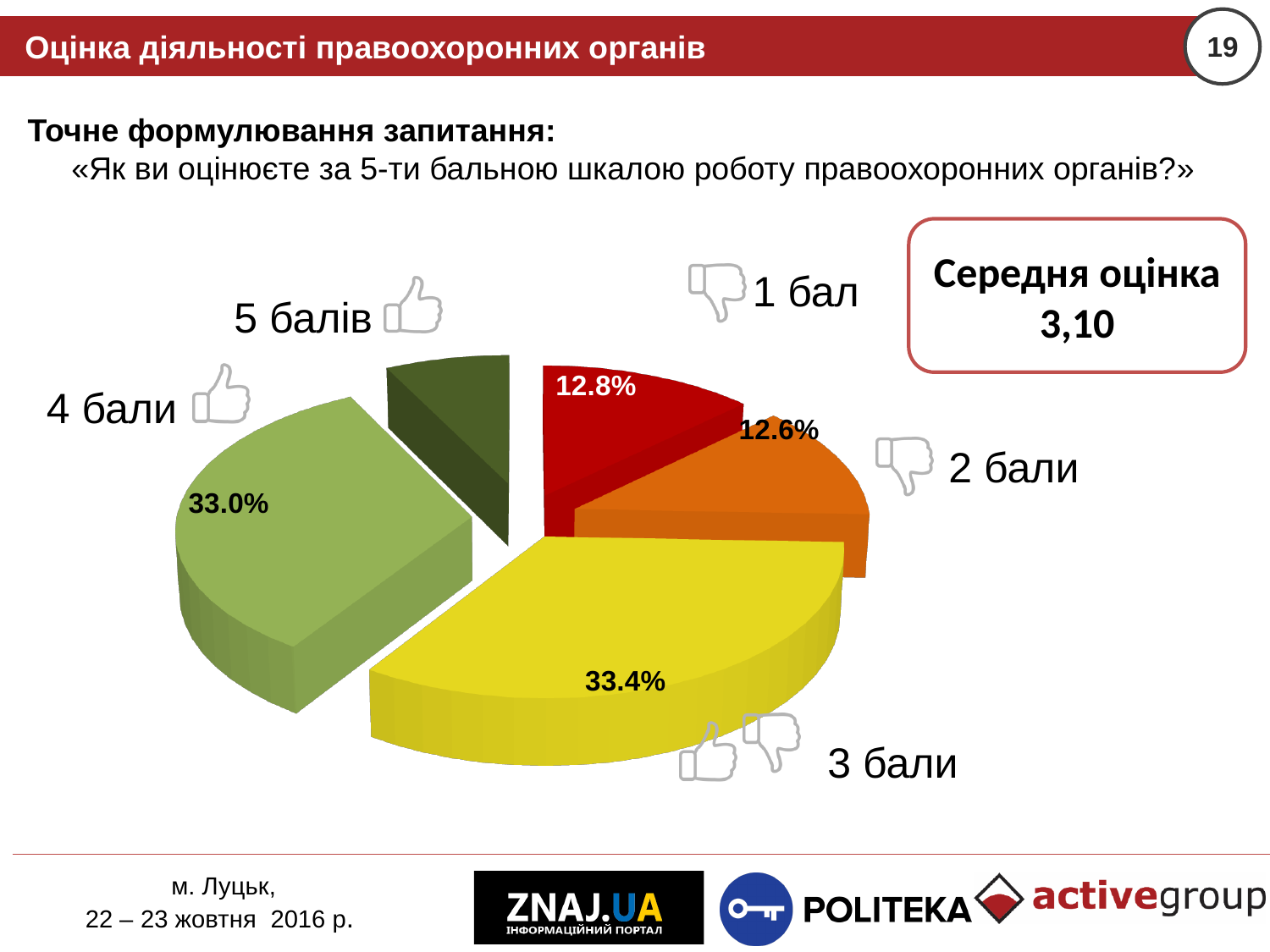
What percentage of respondents gave a rating of 1 бал? 12.8% Which rating category has the largest share of the pie? 3 бали What kind of chart is shown on the slide? pie chart What percentage of respondents gave a rating of 3 бали? 33.4% How many rating categories are shown in the pie chart? 5 What average score (Середня оцінка) is shown on the slide? 3,10 What is the combined share of respondents who gave 1 бал or 2 бали? 25.4% What percentage of respondents gave a rating of 4 бали? 33.0% What percentage of respondents gave a rating of 2 бали? 12.6% Which rating category has the smallest share of the pie? 5 балів What is the difference in percentage points between the 3 бали and 4 бали shares? 0.4 Which share is larger: 1 бал or 2 бали? 1 бал